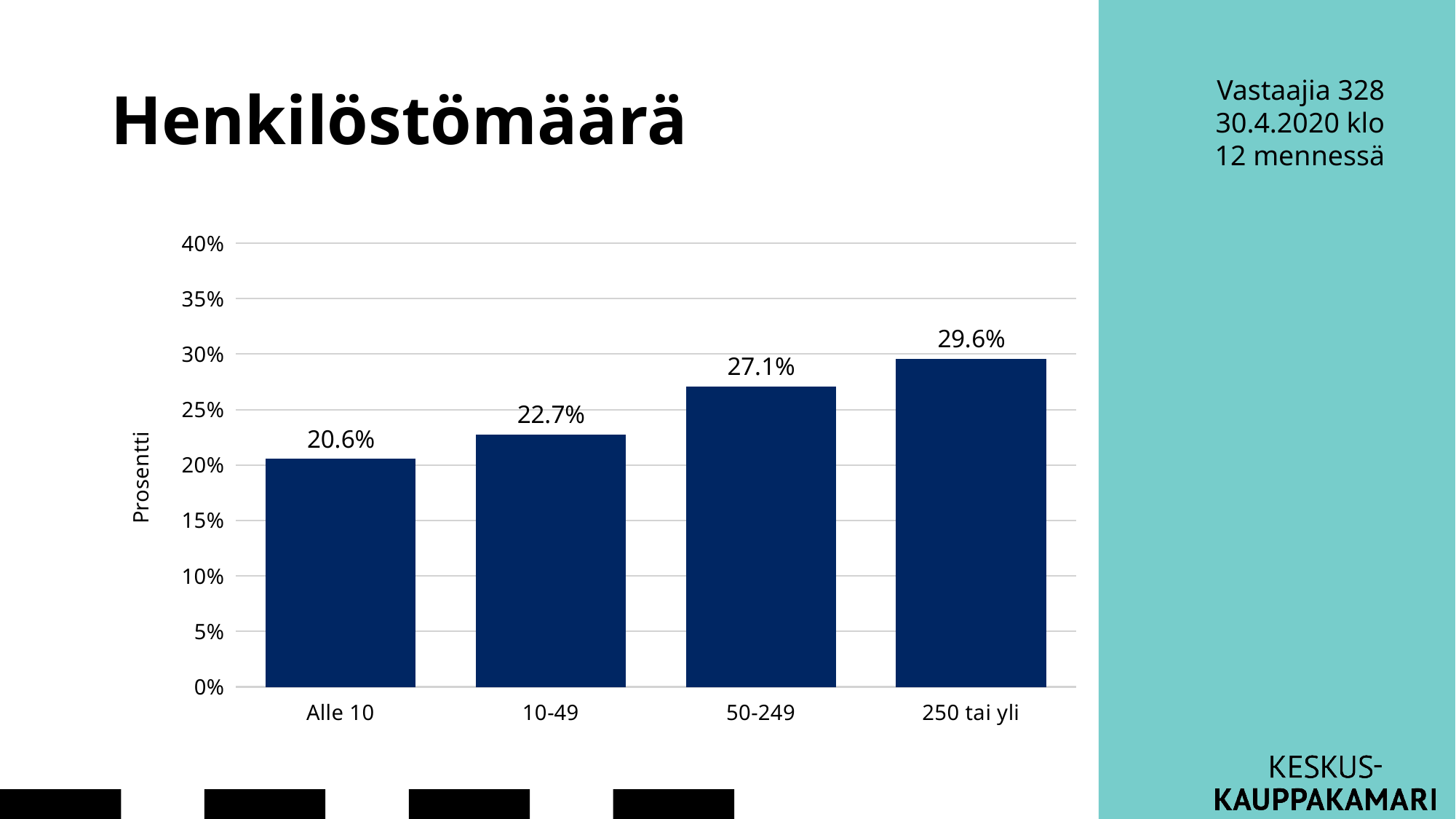
What kind of chart is shown on the slide? bar chart What is the value for the '250 tai yli' category? 29.6% Do the values rise or fall from left to right along the x axis? rise What is the difference between the values for '250 tai yli' and 'Alle 10'? 9.0% Is the value for '50-249' greater or less than 25%? greater How many categories are shown on the x axis? 4 Which category has the lowest value? Alle 10 What is the value for the '10-49' category? 22.7% Which is larger, the value for '10-49' or the value for '50-249'? 50-249 What is the value for the '50-249' category? 27.1% What is the value for the 'Alle 10' category? 20.6% Which category has the highest value? 250 tai yli